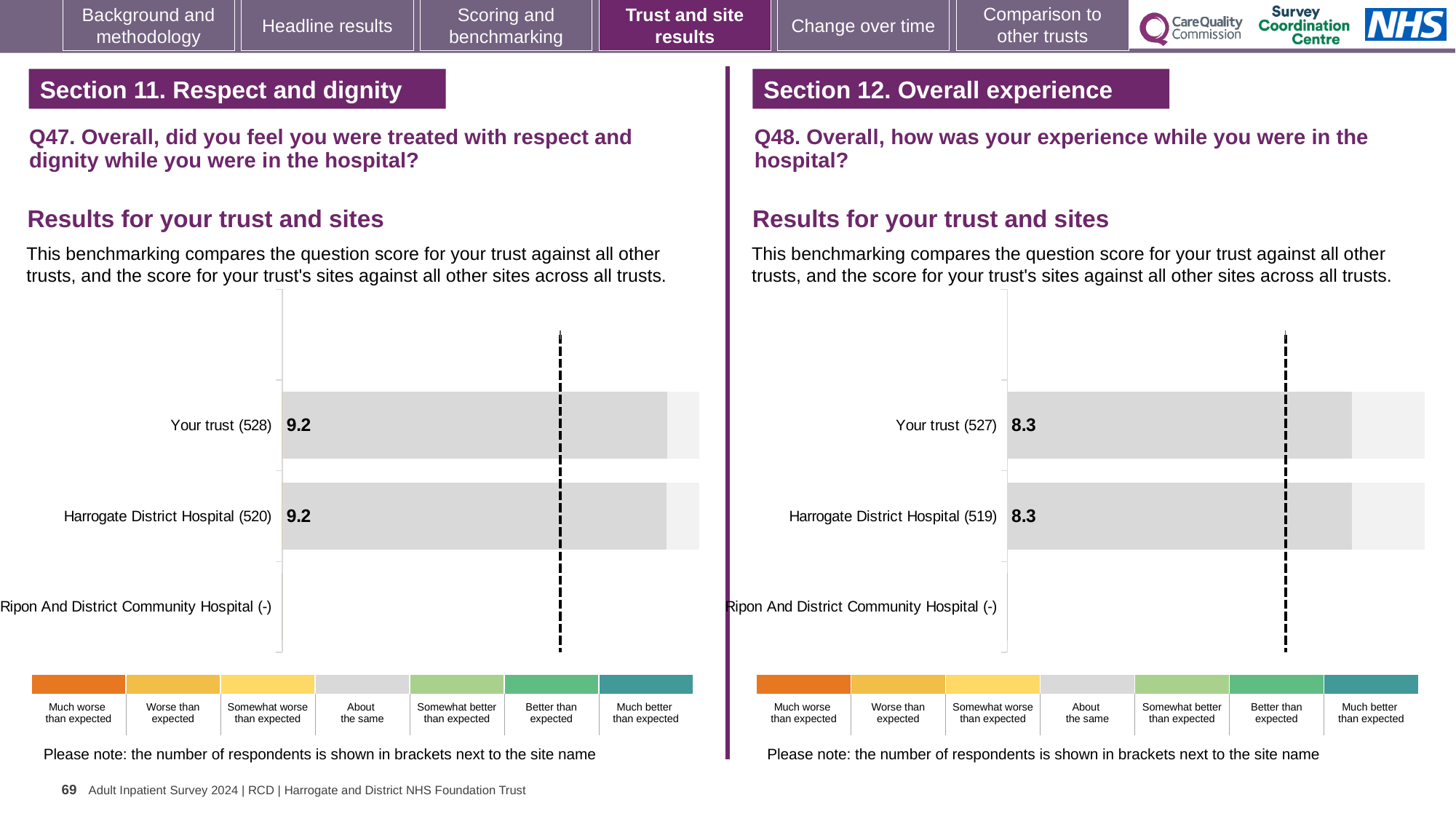
In the Q48 chart on the right, what is the score for Harrogate District Hospital (519)? 8.3 What kind of chart is used for the Q47 results on the left? Bar chart In the Q47 chart on the left, what is the score for Harrogate District Hospital (520)? 9.2 In the Q47 chart on the left, which category has no score shown? Ripon And District Community Hospital (-) In the Q48 chart on the right, what is the score for Your trust (527)? 8.3 In the Q47 chart on the left, what is the difference between the scores for Your trust and Harrogate District Hospital? 0.0 In the Q47 chart on the left, what is the score for Your trust (528)? 9.2 How many benchmark bands are shown in the colour key below the Q48 chart on the right? 7 In the Q48 chart on the right, what is the difference between the scores for Your trust and Harrogate District Hospital? 0.0 In the Q48 chart on the right, how many respondents are shown in brackets for Your trust? 527 How many site/trust categories are listed on the Q48 chart on the right? 3 How many site/trust categories are listed on the Q47 chart on the left? 3